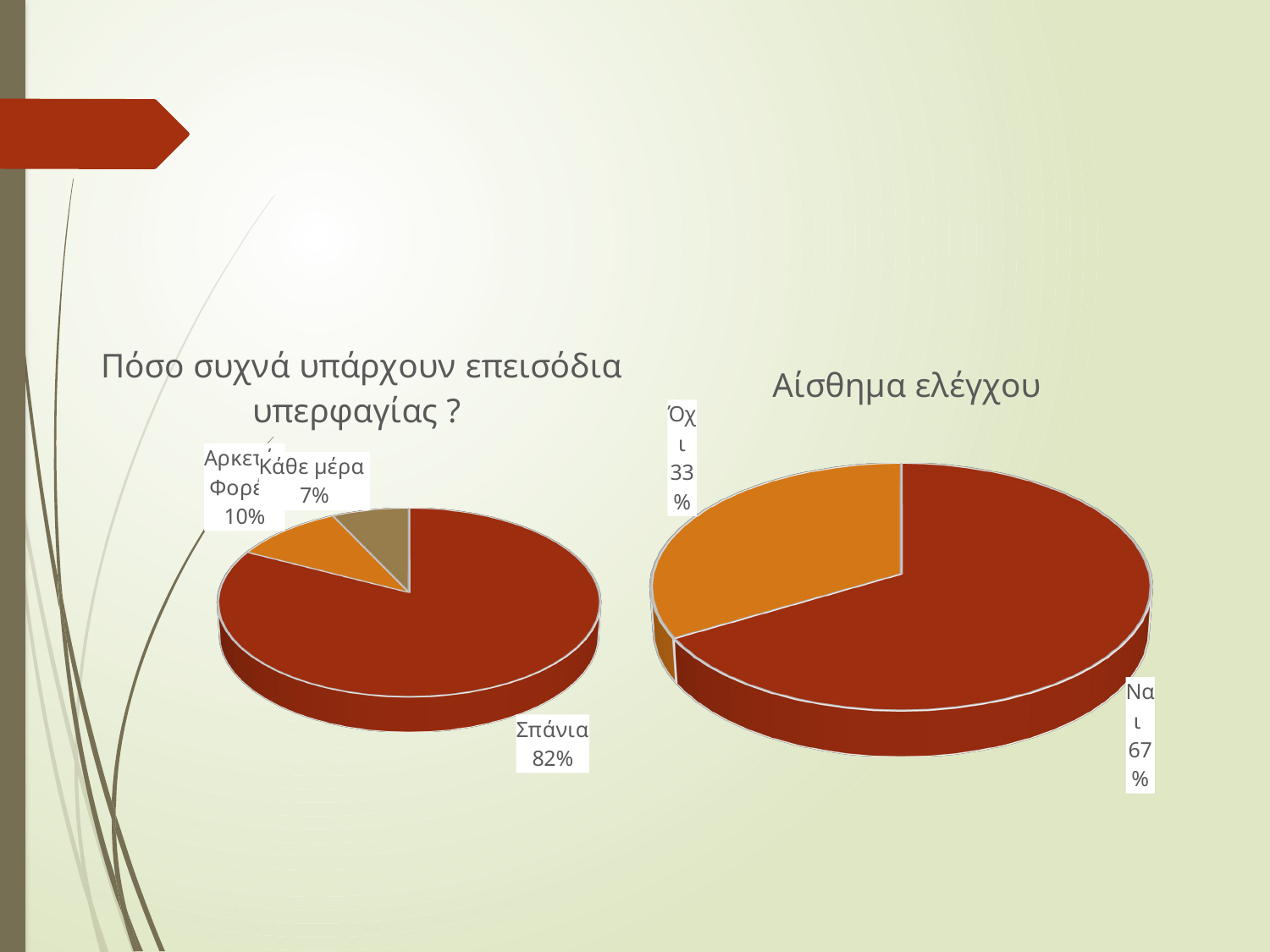
In the chart titled "Αίσθημα ελέγχου", what is the difference in percentage points between "Ναι" and "Όχι"? 34 In the chart titled "Πόσο συχνά υπάρχουν επεισόδια υπερφαγίας ?", what share does "Σπάνια" have? 82% What kind of chart is the chart titled "Αίσθημα ελέγχου"? pie chart How many slices does the chart titled "Πόσο συχνά υπάρχουν επεισόδια υπερφαγίας ?" have? 3 In the chart titled "Πόσο συχνά υπάρχουν επεισόδια υπερφαγίας ?", what share does "Κάθε μέρα" have? 7% In the chart titled "Αίσθημα ελέγχου", what share does "Όχι" have? 33% In the chart titled "Αίσθημα ελέγχου", which slice is the largest? Ναι In the chart titled "Πόσο συχνά υπάρχουν επεισόδια υπερφαγίας ?", which slice is the smallest? Κάθε μέρα In the chart titled "Πόσο συχνά υπάρχουν επεισόδια υπερφαγίας ?", which slice is the largest? Σπάνια In the chart titled "Πόσο συχνά υπάρχουν επεισόδια υπερφαγίας ?", what is the difference in percentage points between "Σπάνια" and "Κάθε μέρα"? 75 How many slices does the chart titled "Αίσθημα ελέγχου" have? 2